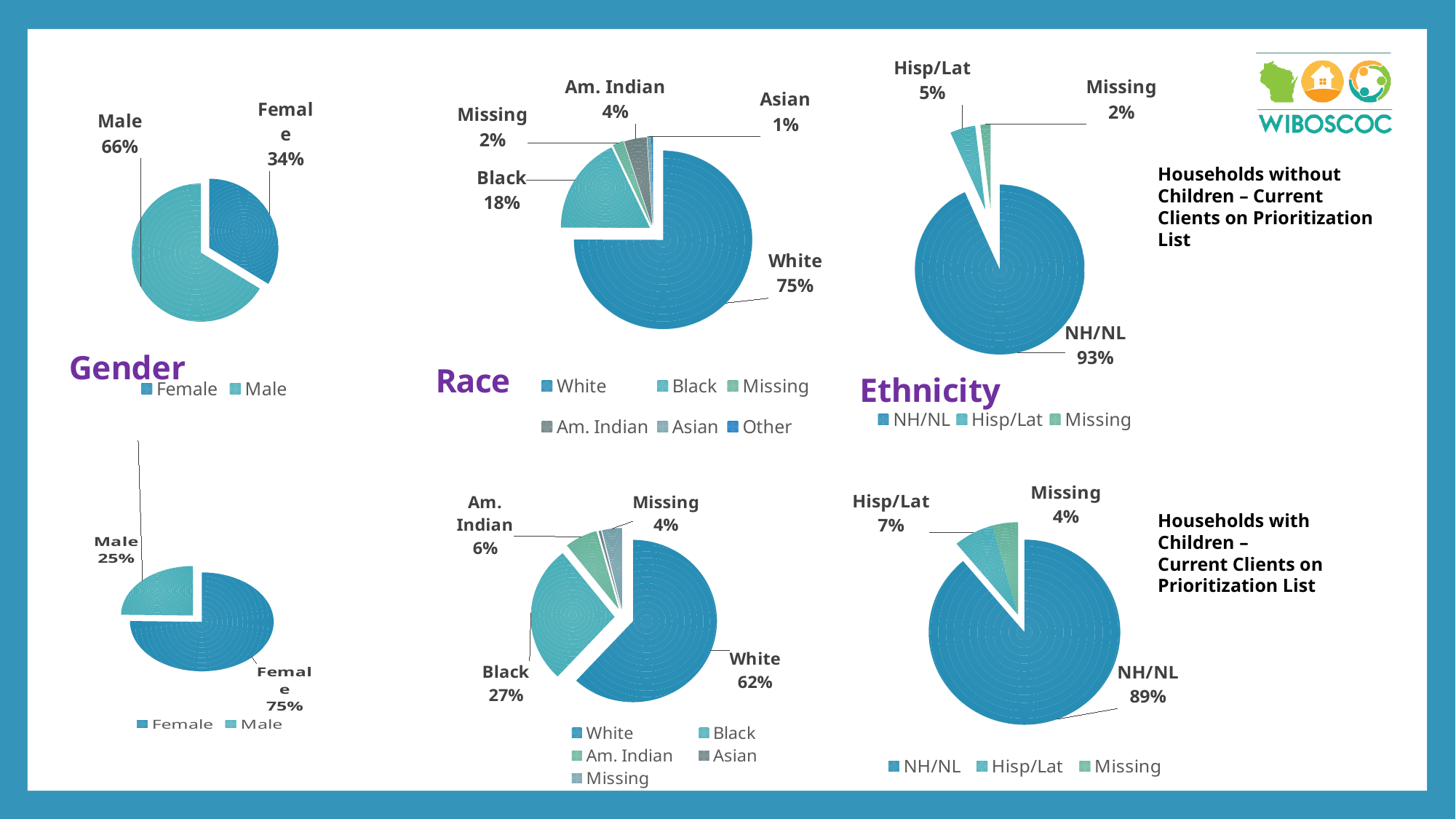
In the Race pie chart for Households without Children (top middle), what share is Black? 18% In the Gender pie chart for Households with Children (bottom left), what share is Female? 75% How many entries does the legend of the Ethnicity chart for Households with Children (bottom right) list? 3 In the Gender pie chart for Households without Children (top left), what share is Male? 66% In the Race pie chart for Households without Children (top middle), which labelled category has the smallest share? Asian In the Ethnicity pie chart for Households without Children (top right), what share is Hisp/Lat? 5% In the Race pie chart for Households with Children (bottom middle), which is larger: Black or Am. Indian? Black What type of chart is used for the Gender data for Households without Children (top left)? Pie chart In the Ethnicity pie chart for Households without Children (top right), what share is NH/NL? 93% In the Race pie chart for Households with Children (bottom middle), which category has the largest share? White How many entries does the legend of the Race chart for Households without Children (top middle) list? 6 In the Ethnicity pie chart for Households with Children (bottom right), what is the difference between the NH/NL share and the Hisp/Lat share? 82%